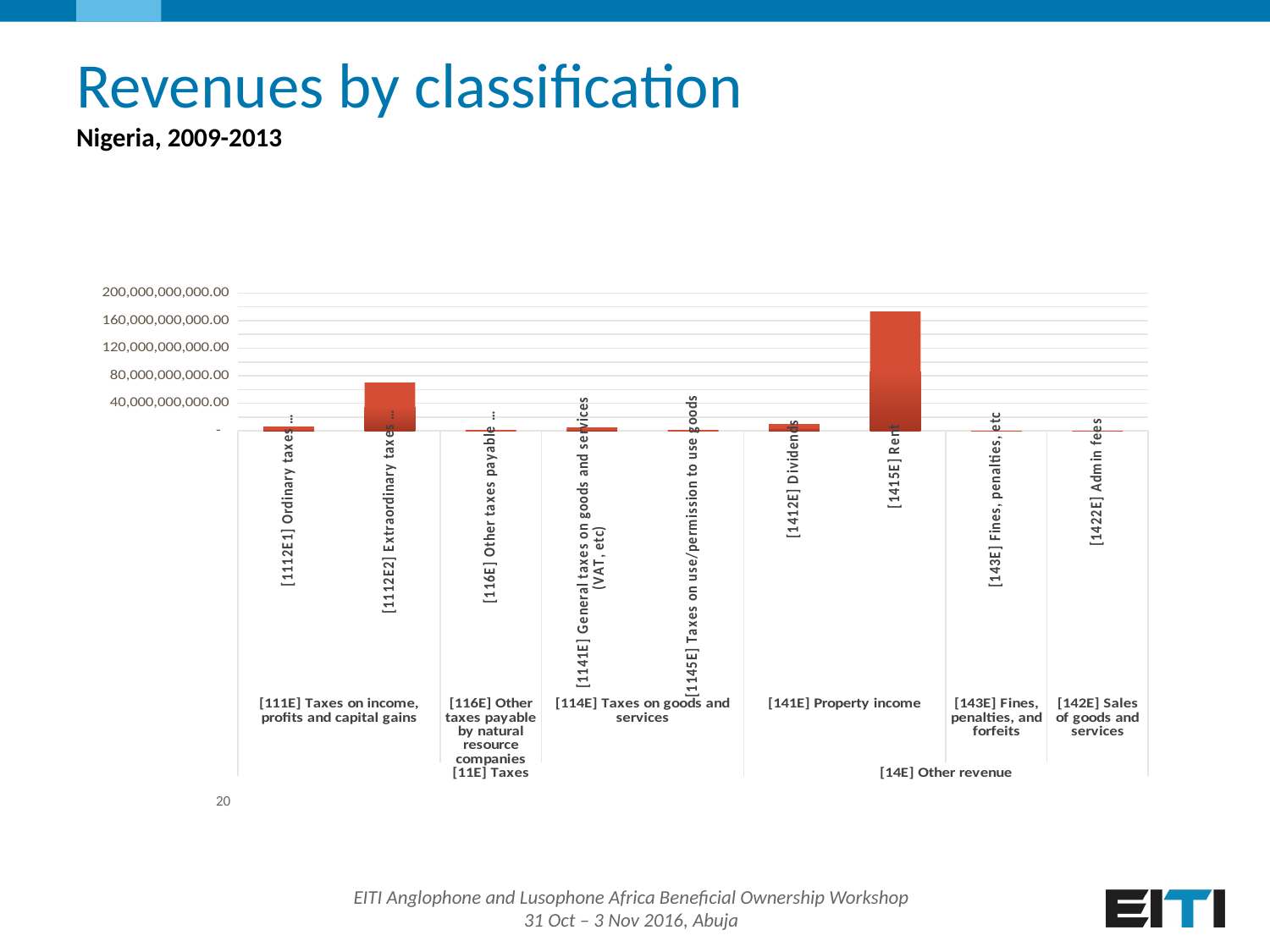
What kind of chart is shown on the slide? bar chart Which is larger, the value for [1112E2] Extraordinary taxes or the value for [1412E] Dividends? [1112E2] Extraordinary taxes Is the value for [1112E2] Extraordinary taxes greater or less than 80,000,000,000.00? less Which is larger, the value for [1412E] Dividends or the value for [1422E] Admin fees? [1412E] Dividends Is the value for [1112E2] Extraordinary taxes greater or less than 40,000,000,000.00? greater What is the title of the slide containing the chart? Revenues by classification Is the value for [1412E] Dividends greater or less than 40,000,000,000.00? less Which is larger, the value for [1415E] Rent or the value for [1112E2] Extraordinary taxes? [1415E] Rent How many bars (categories) are plotted in the chart? 9 What country and period does the chart cover, according to the subtitle? Nigeria, 2009-2013 Which category has the highest value in the chart? [1415E] Rent